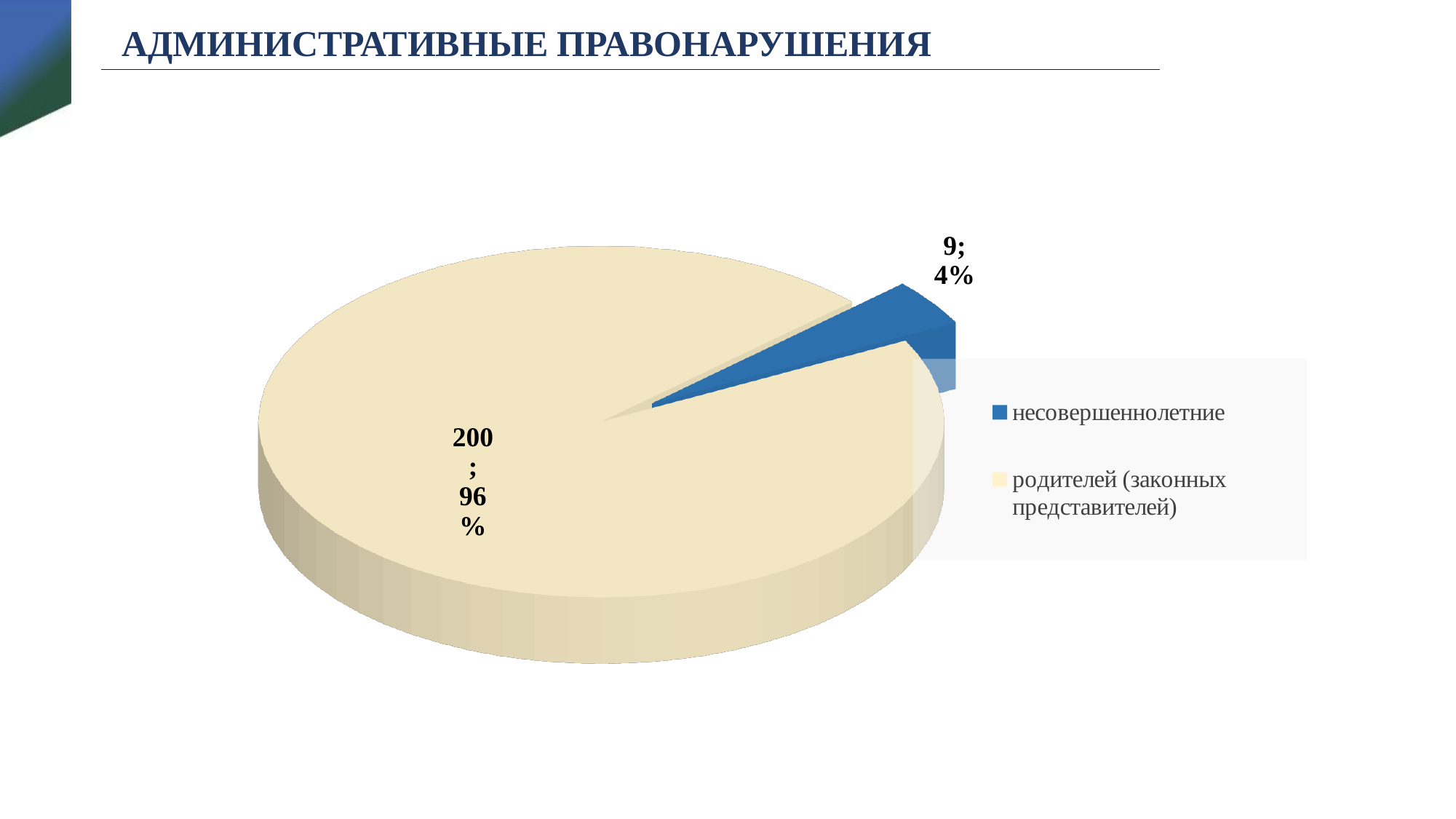
What is the total of the two values shown in the pie chart? 209 What is the value for несовершеннолетние? 9 What is the difference between the values for родителей (законных представителей) and несовершеннолетние? 191 Which is larger, the value for несовершеннолетние or the value for родителей (законных представителей)? родителей (законных представителей) What share of the pie does the родителей (законных представителей) slice represent? 96% What share of the pie does the несовершеннолетние slice represent? 4% Which category has the smallest slice? несовершеннолетние What is the value for родителей (законных представителей)? 200 What colour is the несовершеннолетние slice? blue What kind of chart is shown on the slide? pie chart How many slices does the pie chart have? 2 Which category has the largest slice? родителей (законных представителей)